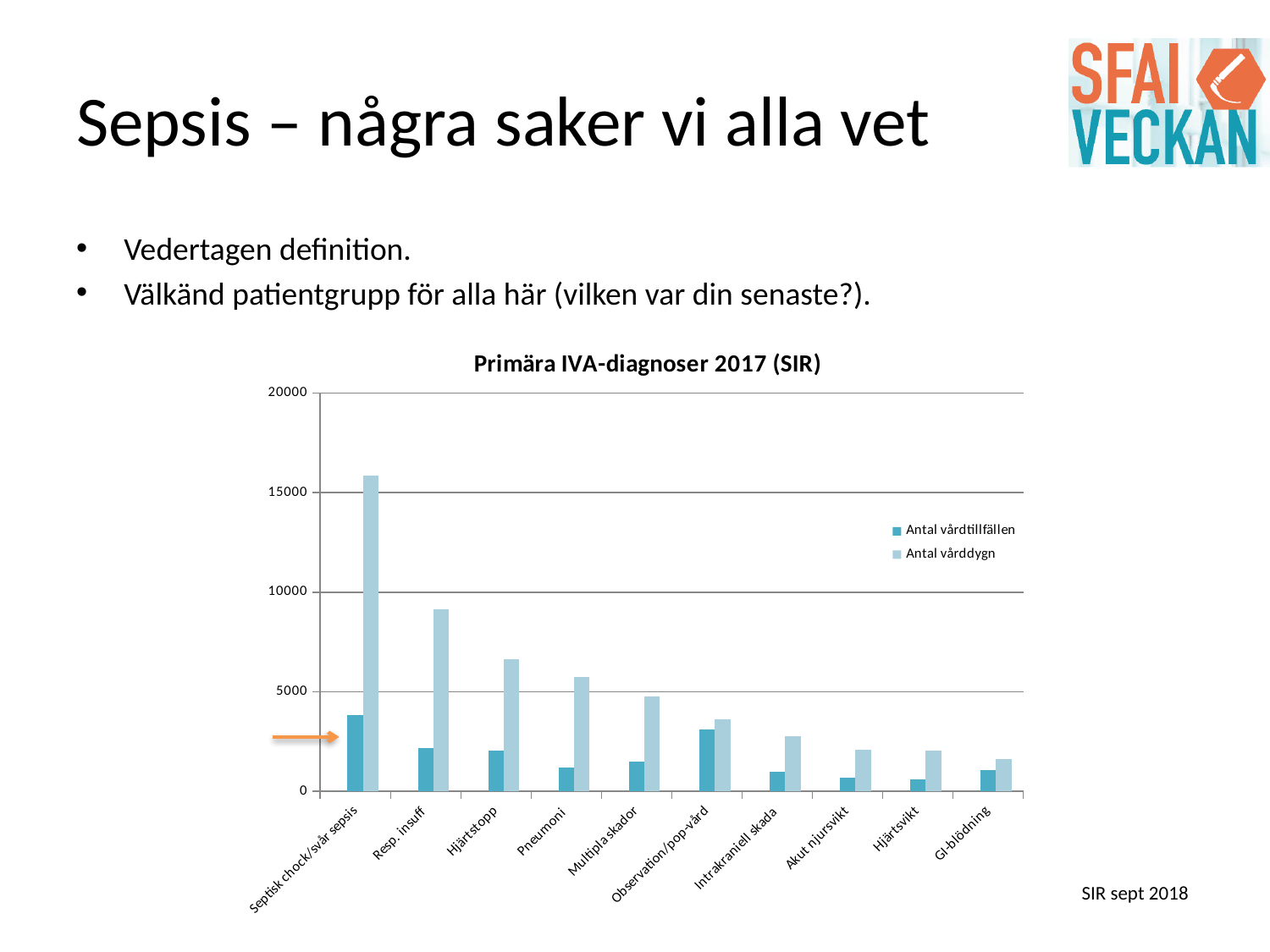
Which category has the highest value for Antal vårdtillfällen? Septisk chock/svår sepsis Which has the larger Antal vårddygn value, Resp. insuff or Hjärtstopp? Resp. insuff How many diagnosis categories are shown on the x axis of the chart? 10 What is the title of the chart? Primära IVA-diagnoser 2017 (SIR) Do the Antal vårddygn values generally rise or fall moving left to right along the x axis? fall Which category has the lowest value for Antal vårddygn? GI-blödning Is the Antal vårddygn value for Resp. insuff greater or less than 10000? less Is the Antal vårdtillfällen value for Septisk chock/svår sepsis greater or less than 5000? less How many series does the chart's legend list? 2 Which category has the highest value for Antal vårddygn? Septisk chock/svår sepsis Is the Antal vårddygn value for Septisk chock/svår sepsis greater or less than 15000? greater What kind of chart is shown on the slide? Bar chart